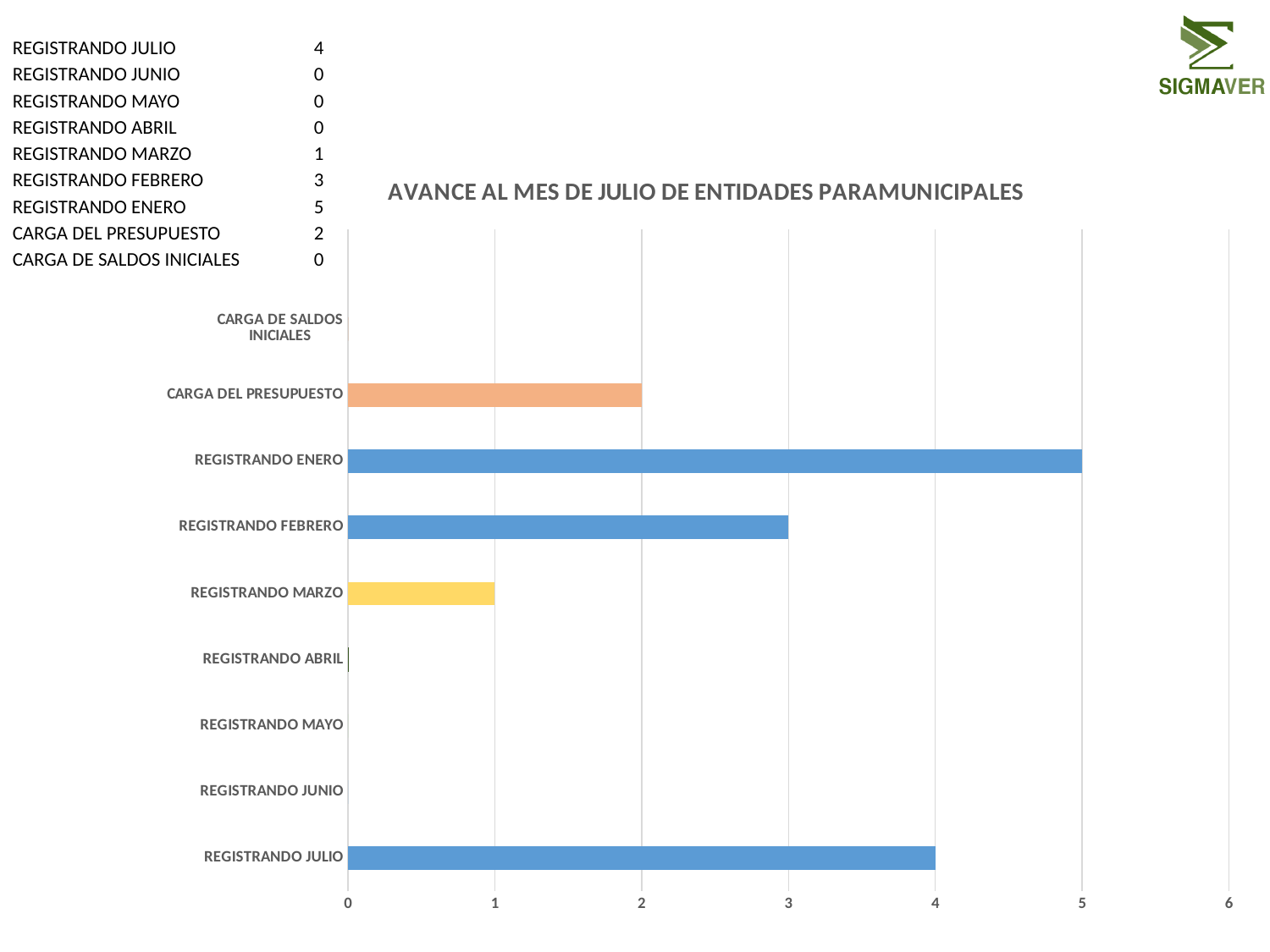
What is the value for CARGA DEL PRESUPUESTO? 2 What is the value for REGISTRANDO MARZO? 1 What is the highest value shown on the x axis? 6 Which category has the highest value? REGISTRANDO ENERO How many categories are shown on the chart? 9 What is the value for REGISTRANDO JULIO? 4 What is the difference between the values for REGISTRANDO ENERO and REGISTRANDO FEBRERO? 2 What is the value for REGISTRANDO ENERO? 5 Which is larger, the value for REGISTRANDO JULIO or the value for REGISTRANDO FEBRERO? REGISTRANDO JULIO What is the title of the chart? AVANCE AL MES DE JULIO DE ENTIDADES PARAMUNICIPALES What kind of chart is shown on the slide? bar chart Is the value for REGISTRANDO ENERO greater or less than 3? greater